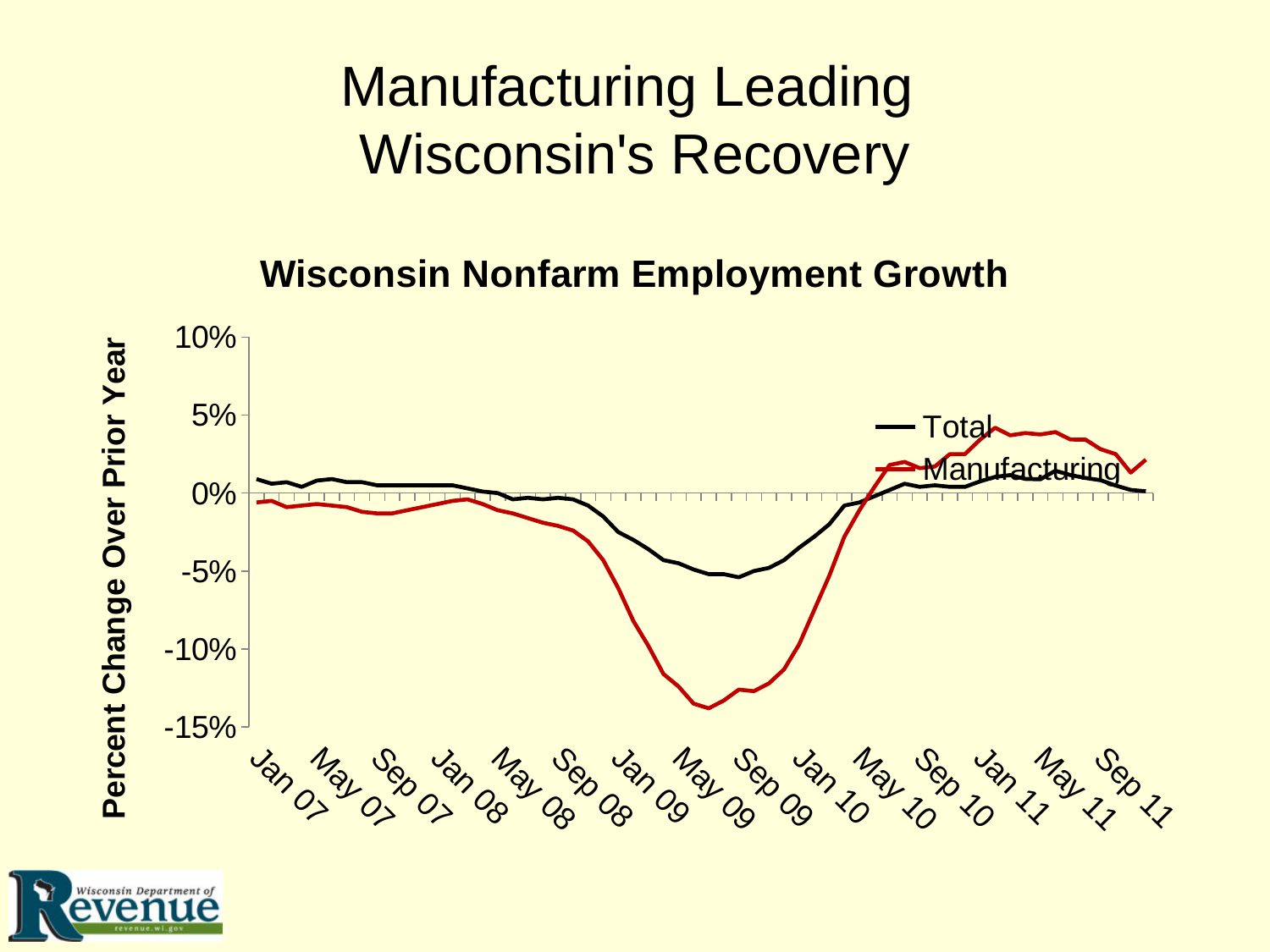
Is the value for Manufacturing at Jan 11 greater or less than 0%? greater Is the value for Total at Jan 09 greater or less than -5%? greater Does the Manufacturing series rise or fall between Sep 09 and Jan 11? rise How many series does the legend list? 2 What are the two series named in the legend? Total and Manufacturing Is the value for Manufacturing at Jan 09 greater or less than -5%? less What kind of chart is shown on the slide? line chart Which series has the lower value at May 09, Total or Manufacturing? Manufacturing Does the Manufacturing series rise or fall between Jan 09 and May 09? fall What is the title of the chart? Wisconsin Nonfarm Employment Growth